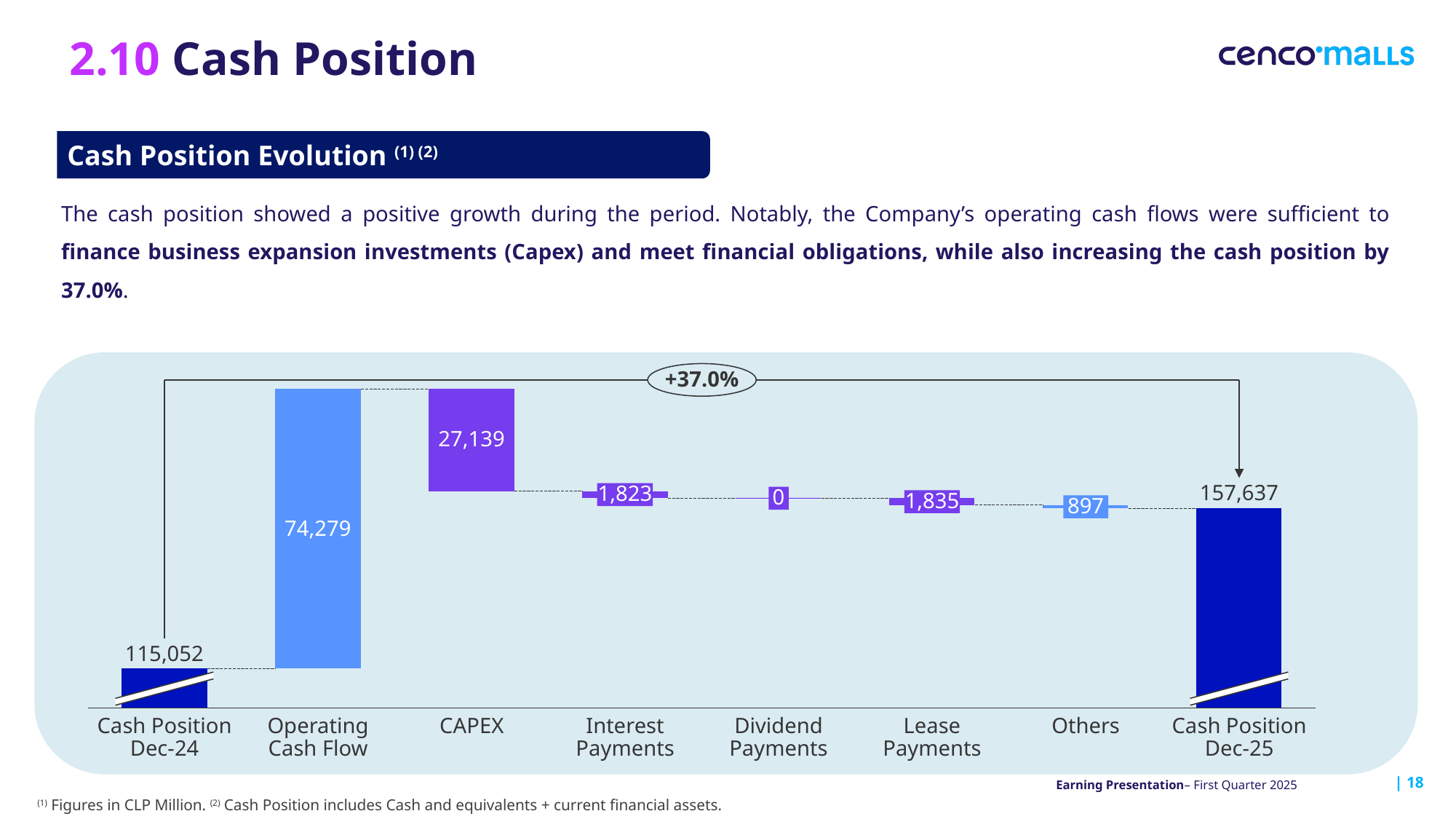
What is the value for Others? 897 What is the value for Operating Cash Flow? 74,279 What is the value for Lease Payments? 1,835 What is the value for Cash Position Dec-24? 115,052 What is the difference between Cash Position Dec-25 and Cash Position Dec-24? 42,585 What is the value for CAPEX? 27,139 What is the value for Dividend Payments? 0 What is the value for Cash Position Dec-25? 157,637 What percentage change is shown above the chart between Cash Position Dec-24 and Cash Position Dec-25? +37.0% What is the value for Interest Payments? 1,823 Which category has the lowest value? Dividend Payments How many categories are shown on the x axis? 8